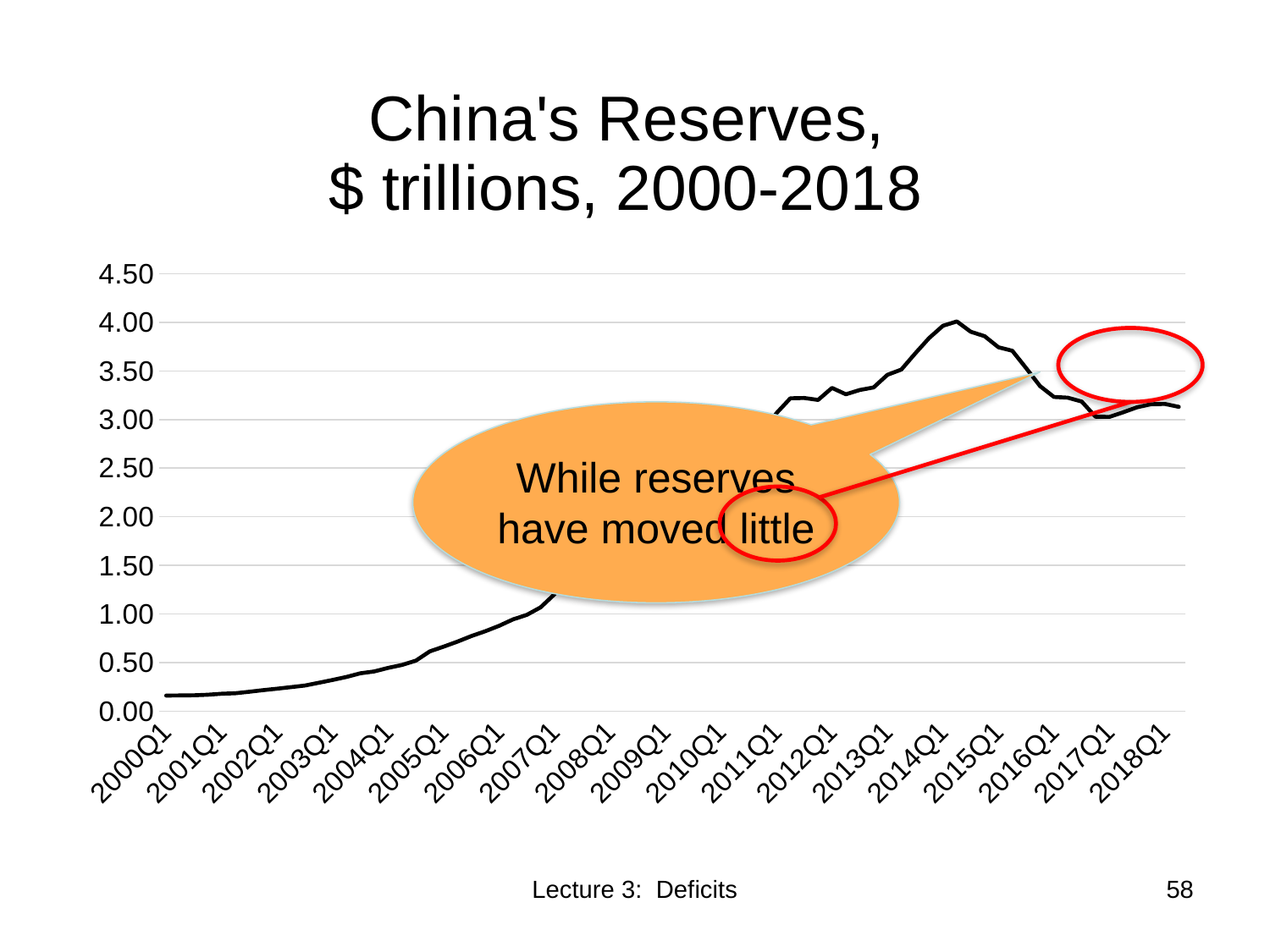
Is the value for 2005Q1 greater or less than 1.00? less What does the orange callout on the chart say? While reserves have moved little Is the value for 2018Q1 greater or less than 2.50? greater Is the value for 2012Q1 greater or less than 3.00? greater How many year labels are shown along the x axis? 19 What is the title of the chart? China's Reserves, $ trillions, 2000-2018 What kind of chart is shown on the slide? line chart Do reserves rise or fall between 2000Q1 and 2014Q1? rise In which year does the line reach its highest point? 2014 Which of 2000Q1 or 2018Q1 has the higher reserves value? 2018Q1